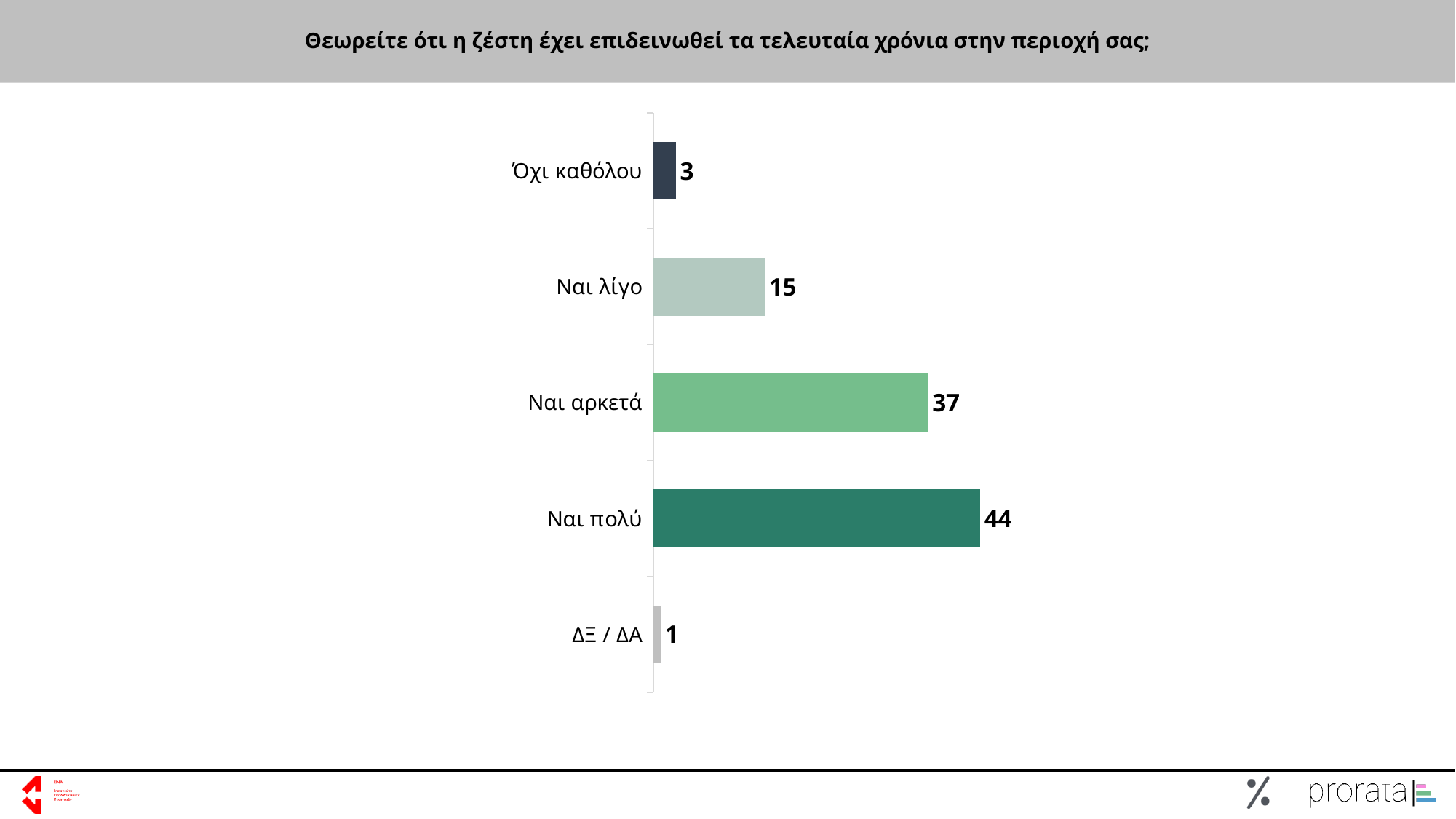
What is the difference between the values for Ναι λίγο and Όχι καθόλου? 12 What is the value for Ναι πολύ? 44 What is the value for Όχι καθόλου? 3 Which category has the highest value? Ναι πολύ What kind of chart is shown on the slide? Bar chart What is the value for ΔΞ / ΔΑ? 1 What is the value for Ναι λίγο? 15 Which is larger, the value for Ναι αρκετά or the value for Ναι λίγο? Ναι αρκετά What is the value for Ναι αρκετά? 37 How many categories are shown in the chart? 5 What is the difference between the values for Ναι πολύ and Ναι αρκετά? 7 Which category has the lowest value? ΔΞ / ΔΑ